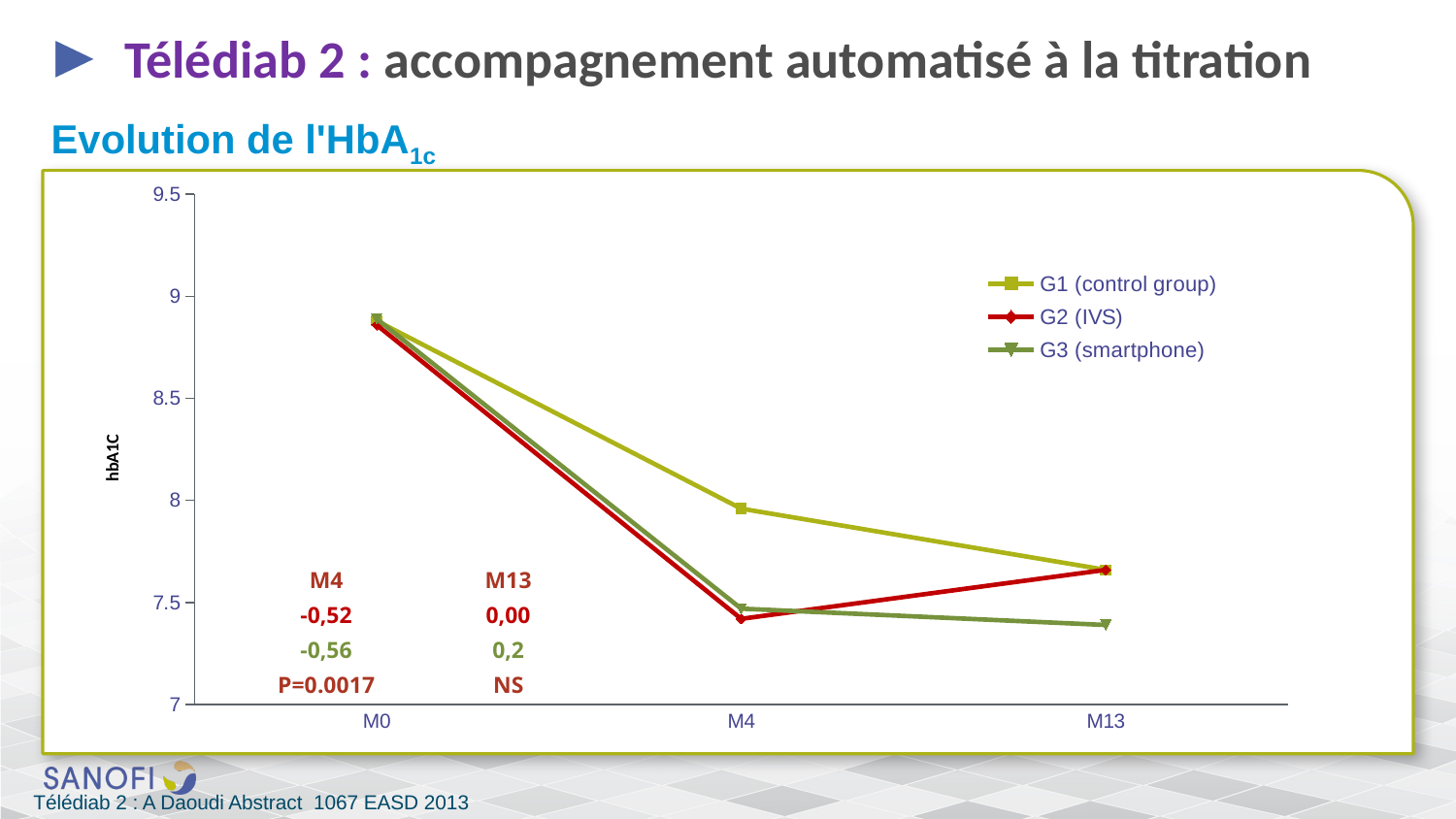
Is the value for G1 (control group) at M0 greater or less than 8.5? greater At M4, which series has the highest value? G1 (control group) How many series does the legend list? 3 At M13, which series has the lowest value? G3 (smartphone) What kind of chart is shown on the slide? line chart Is the value for G3 (smartphone) at M13 greater or less than 7.5? less How many time points are shown on the x axis? 3 What is the label of the y axis? hbA1C Is the value for G1 (control group) at M13 greater or less than 7.5? greater At M4, which is larger: the value for G1 (control group) or G2 (IVS)? G1 (control group) Which series is labelled with the green square markers in the legend? G1 (control group) Does the G1 (control group) line rise or fall from M0 to M13? fall